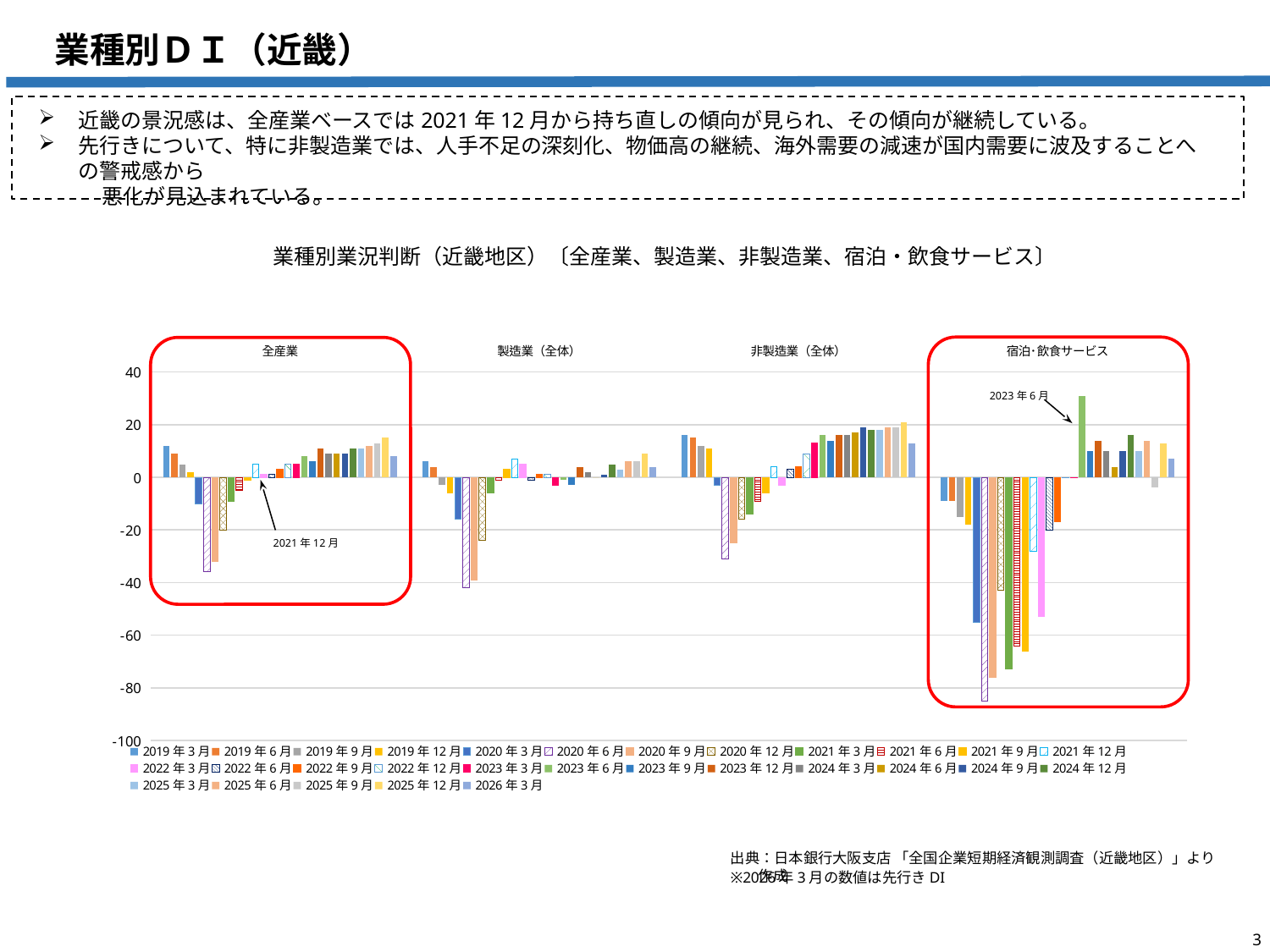
How many series (survey periods) does the chart legend list? 29 What is the title of the chart? 業種別業況判断（近畿地区）〔全産業、製造業、非製造業、宿泊・飲食サービス〕 Is the value for 2020年6月 in the 全産業 group greater or less than -20? less Which two industry groups are outlined with red rounded boxes on the chart? 全産業 and 宿泊・飲食サービス Is the value for 2023年6月 in the 宿泊・飲食サービス group greater or less than 20? greater In the 全産業 group, do the bars generally rise or fall from 2021年12月 to 2025年12月? rise Which is lower, the 2020年6月 bar in the 全産業 group or the 2020年6月 bar in the 宿泊・飲食サービス group? 宿泊・飲食サービス Is the value for 2020年6月 in the 宿泊・飲食サービス group greater or less than -80? less Which industry group contains the tallest positive bar in the chart? 宿泊・飲食サービス Which industry group contains the lowest bar in the chart? 宿泊・飲食サービス How many industry groups are plotted along the x axis of the chart? 4 What kind of chart is shown on the slide? bar chart